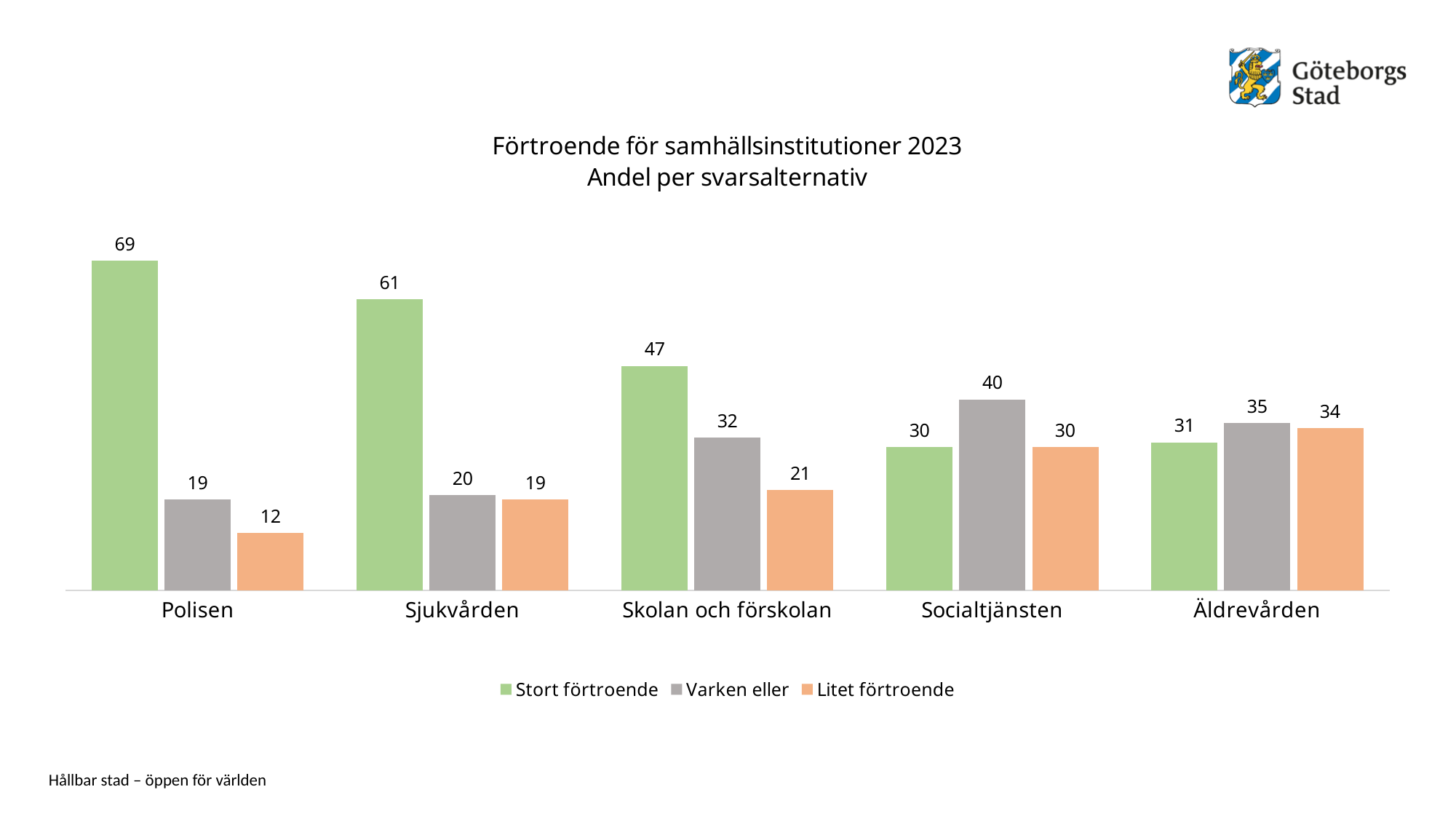
What is the value for Litet förtroende for Äldrevården? 34 What kind of chart is shown on the slide? Bar chart How many categories are shown on the x axis? 5 Which category has the lowest value for Litet förtroende? Polisen How many series does the legend list? 3 Do the Stort förtroende values rise or fall from Polisen to Socialtjänsten? Fall What is the value for Varken eller for Socialtjänsten? 40 What is the value for Stort förtroende for Polisen? 69 What is the difference between Stort förtroende for Polisen and Stort förtroende for Sjukvården? 8 Which is larger for Äldrevården: Stort förtroende or Litet förtroende? Litet förtroende What is the title of the chart? Förtroende för samhällsinstitutioner 2023 Andel per svarsalternativ Which category has the highest value for Stort förtroende? Polisen